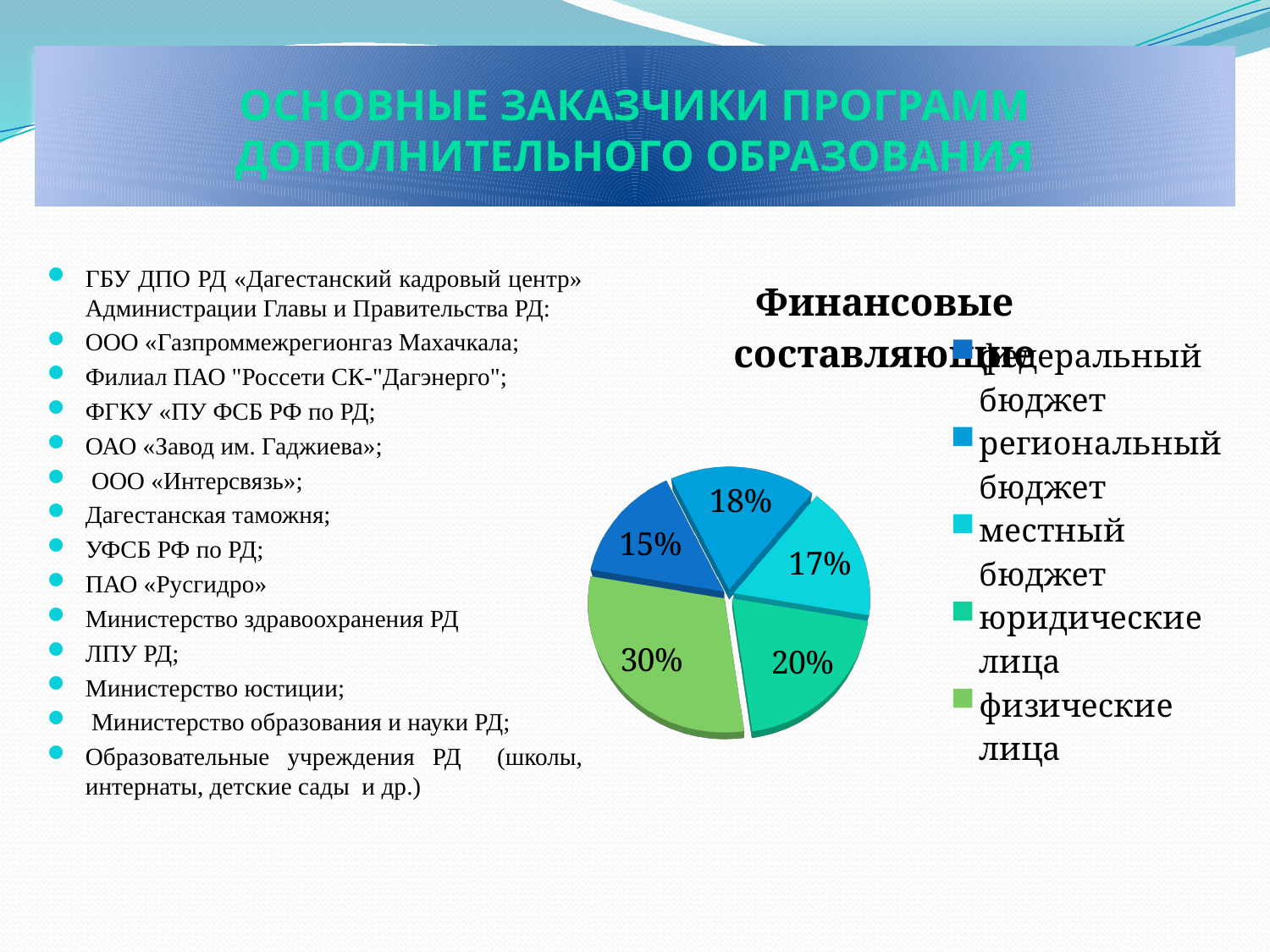
What is the difference between the shares of физические лица and юридические лица? 10% How many slices does the pie chart have? 5 What is the title of the pie chart? Финансовые составляющие What kind of chart is shown on the slide? pie chart What share of the pie does физические лица account for? 30% How many entries does the legend of the pie chart list? 5 What share of the pie does местный бюджет account for? 17% What share of the pie does региональный бюджет account for? 18% Which category has the smallest slice of the pie? федеральный бюджет Which category has the largest slice of the pie? физические лица